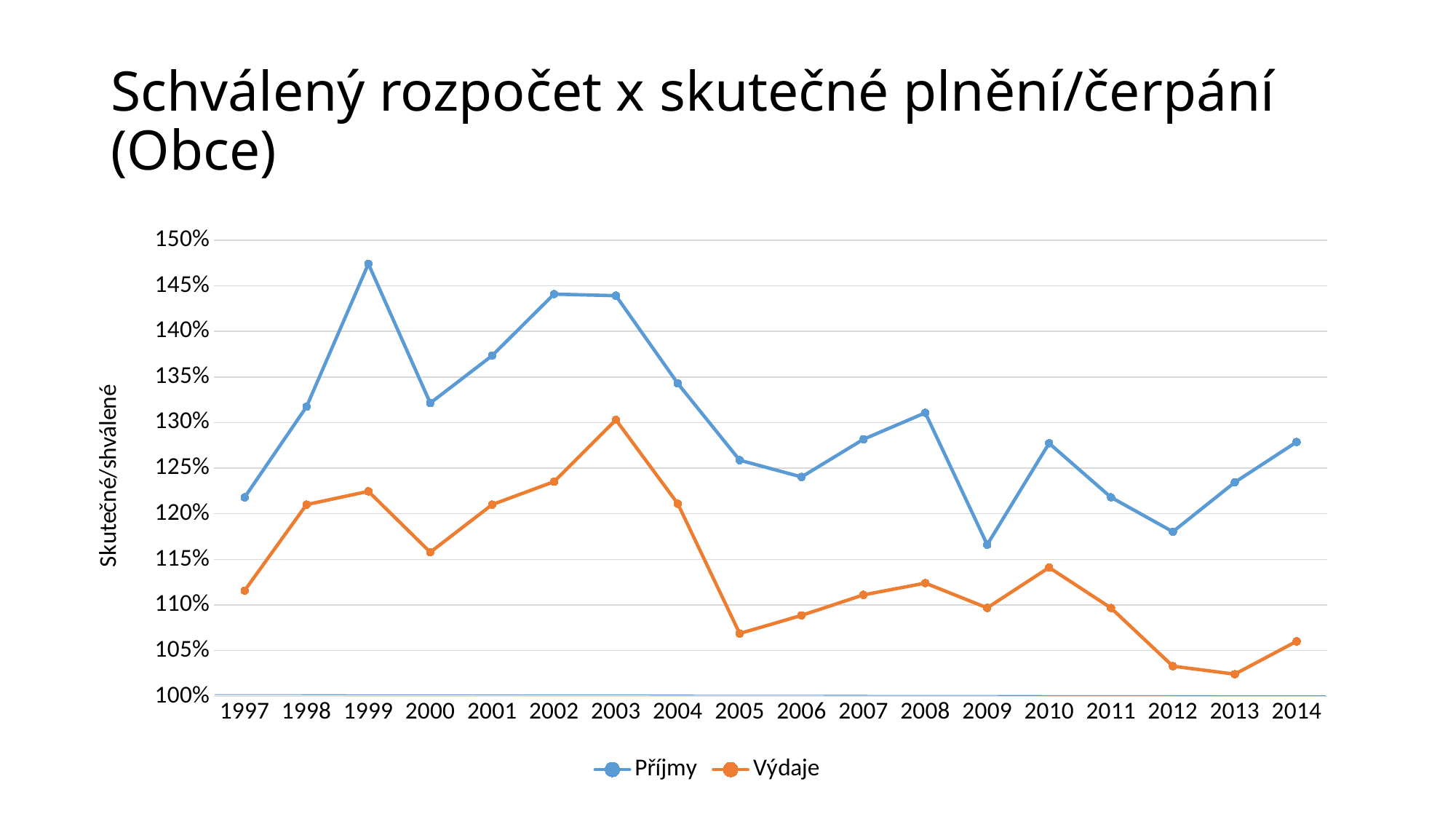
Does the Výdaje series rise or fall from 2010 to 2013? fall In which year does the Výdaje series reach its highest value? 2003 In which year does the Příjmy series reach its highest value? 1999 Is the value for Výdaje in 2012 greater or less than 105%? less How many series does the legend list? 2 In which year does the Příjmy series reach its lowest value? 2009 What kind of chart is shown on the slide? line chart What is the label on the vertical axis? Skutečné/shválené Which series has the larger value in 2005, Příjmy or Výdaje? Příjmy Is the value for Příjmy in 1999 greater or less than 145%? greater Is the value for Výdaje in 2005 greater or less than 110%? less How many years are plotted along the x axis? 18